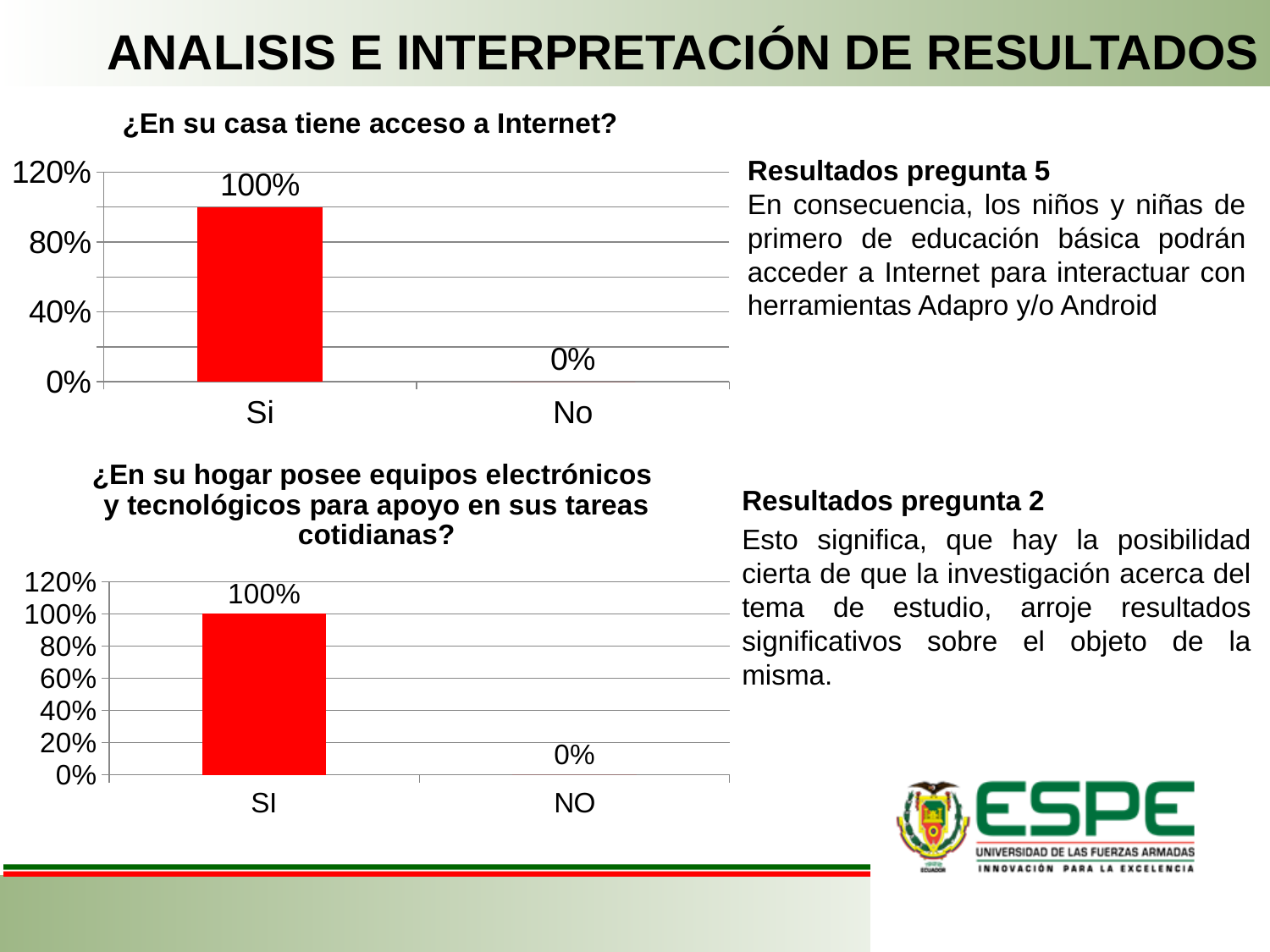
In the top chart '¿En su casa tiene acceso a Internet?', which category has the highest value? Si In the bottom chart '¿En su hogar posee equipos electrónicos y tecnológicos para apoyo en sus tareas cotidianas?', what is the value for 'NO'? 0% In the top chart '¿En su casa tiene acceso a Internet?', what is the difference between the values for 'Si' and 'No'? 100% What colour are the bars in the top chart '¿En su casa tiene acceso a Internet?'? Red In the bottom chart '¿En su hogar posee equipos electrónicos y tecnológicos para apoyo en sus tareas cotidianas?', what is the highest value shown on the y axis? 120% What type of chart is the top chart '¿En su casa tiene acceso a Internet?'? Bar chart In the top chart '¿En su casa tiene acceso a Internet?', what is the value for 'No'? 0% In the top chart '¿En su casa tiene acceso a Internet?', how many categories are shown on the x axis? 2 In the bottom chart '¿En su hogar posee equipos electrónicos y tecnológicos para apoyo en sus tareas cotidianas?', is the value for 'SI' larger or smaller than the value for 'NO'? Larger In the bottom chart '¿En su hogar posee equipos electrónicos y tecnológicos para apoyo en sus tareas cotidianas?', which category has the lowest value? NO In the top chart '¿En su casa tiene acceso a Internet?', what is the value for 'Si'? 100% In the bottom chart '¿En su hogar posee equipos electrónicos y tecnológicos para apoyo en sus tareas cotidianas?', what is the value for 'SI'? 100%